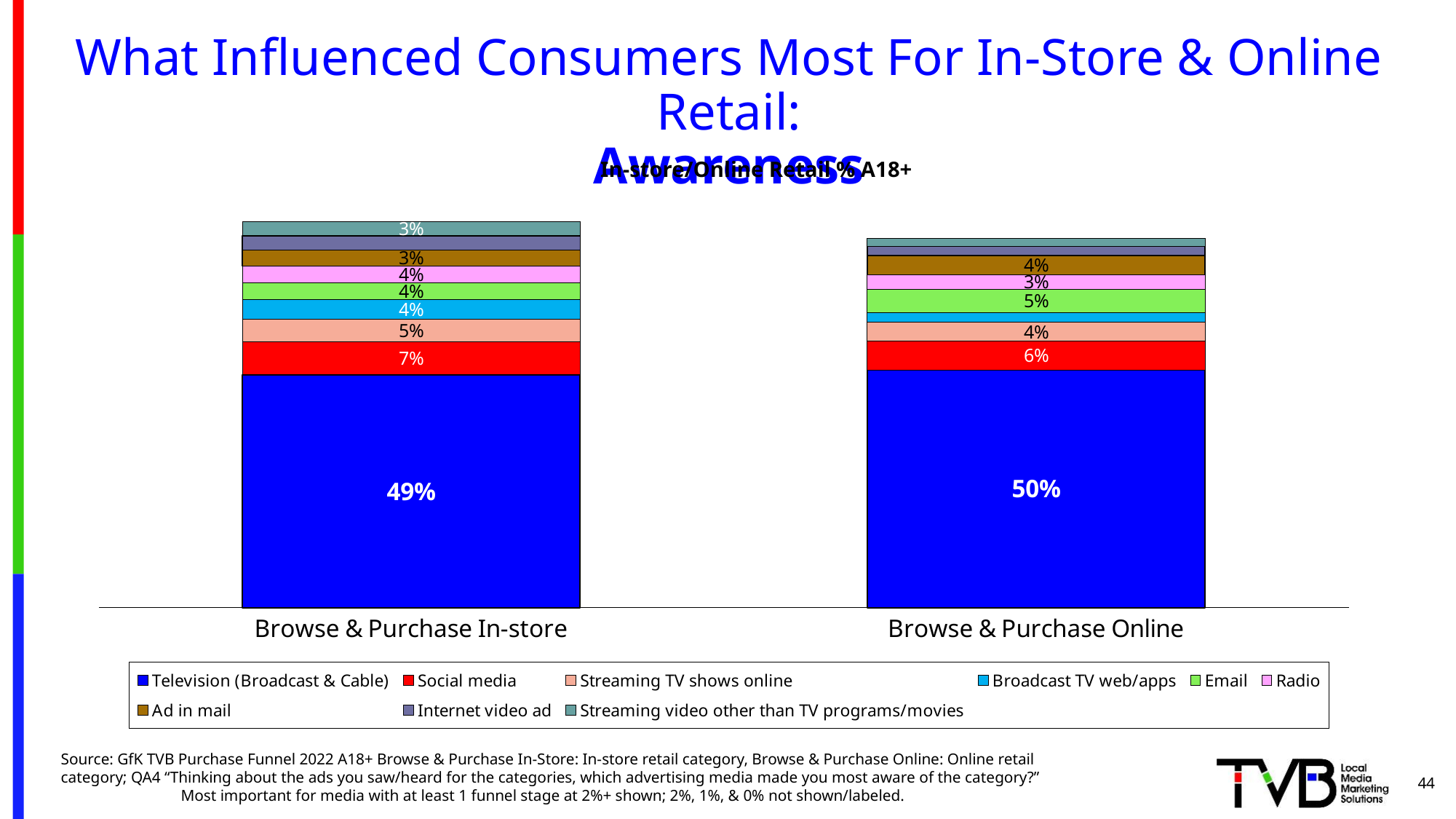
By how many percentage points does the Television (Broadcast & Cable) value for Browse & Purchase Online exceed that for Browse & Purchase In-store? 1 percentage point What percentage does Television (Broadcast & Cable) account for in the Browse & Purchase Online bar? 50% What is the Social media value for Browse & Purchase In-store? 7% Which media segment is the largest in the Browse & Purchase In-store bar? Television (Broadcast & Cable) What kind of chart is shown on the slide? Stacked bar chart What is the Streaming TV shows online value for Browse & Purchase In-store? 5% What is the Social media value for Browse & Purchase Online? 6% What is the Email value for Browse & Purchase Online? 5% What is the Ad in mail value for Browse & Purchase Online? 4% Which has the larger Social media value, Browse & Purchase In-store or Browse & Purchase Online? Browse & Purchase In-store How many series does the legend list? 9 What percentage does Television (Broadcast & Cable) account for in the Browse & Purchase In-store bar? 49%